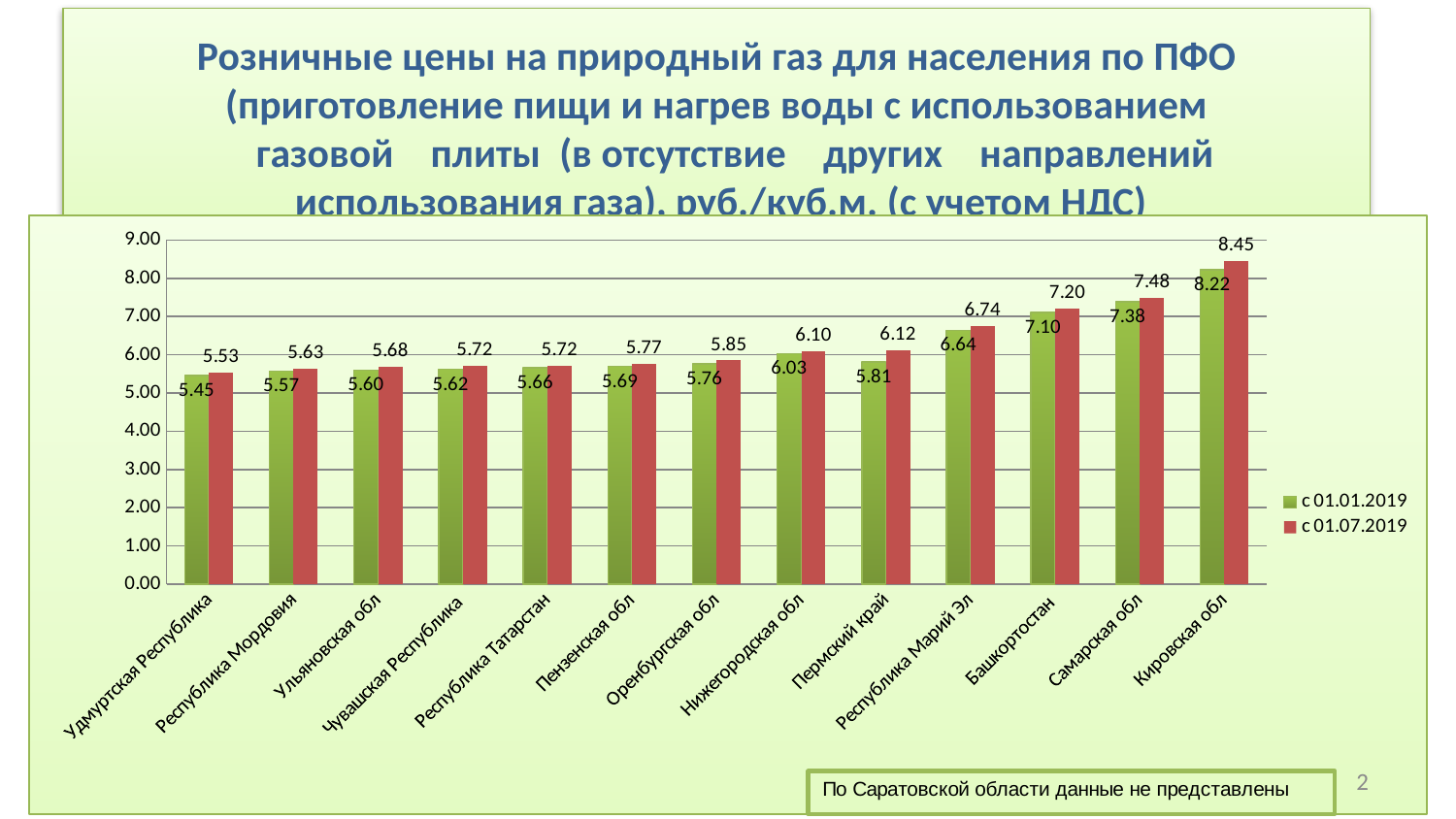
Which region has the lowest value in the с 01.07.2019 series? Удмуртская Республика What kind of chart is shown on the slide? bar chart Is the с 01.07.2019 value for Республика Марий Эл greater or less than 7.00? less What is the difference between the с 01.07.2019 and с 01.01.2019 values for Кировская обл? 0.23 What is the value for Кировская обл in the с 01.07.2019 series? 8.45 What is the value for Башкортостан in the с 01.07.2019 series? 7.20 Which is larger: the с 01.01.2019 value for Нижегородская обл or for Пермский край? Нижегородская обл What is the value for Пермский край in the с 01.01.2019 series? 5.81 How many regions are shown on the x axis of the chart? 13 How many series does the legend list? 2 Which region has the highest value in the с 01.01.2019 series? Кировская обл What is the difference between the с 01.07.2019 values for Самарская обл and Башкортостан? 0.28